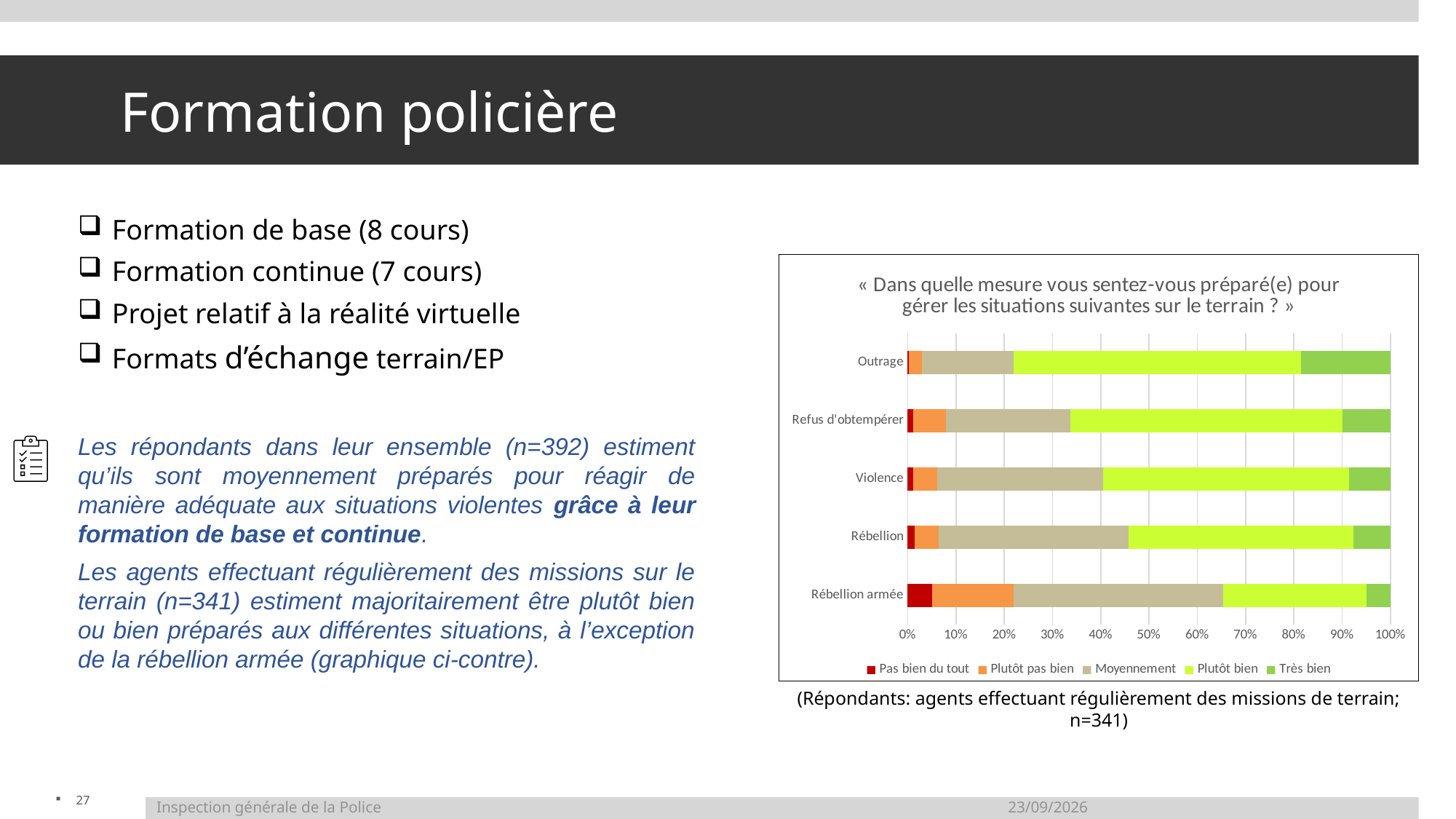
Which situation has the largest 'Pas bien du tout' share? Rébellion armée How many situations (categories) are plotted in the chart? 5 What is the question quoted in the chart title? « Dans quelle mesure vous sentez-vous préparé(e) pour gérer les situations suivantes sur le terrain ? » Which situation has the smallest 'Plutôt bien' share? Rébellion armée Which series is shown in dark red in the chart legend? Pas bien du tout Which situation has the largest 'Très bien' share? Outrage Which has the larger 'Plutôt bien' share, Outrage or Rébellion armée? Outrage Is the 'Pas bien du tout' share for Rébellion armée greater or less than 10%? less Is the 'Très bien' share for Outrage greater or less than 10%? greater What kind of chart is shown on the slide? Stacked bar chart How many series does the chart legend list? 5 Is the 'Plutôt bien' share for Outrage greater or less than 50%? greater